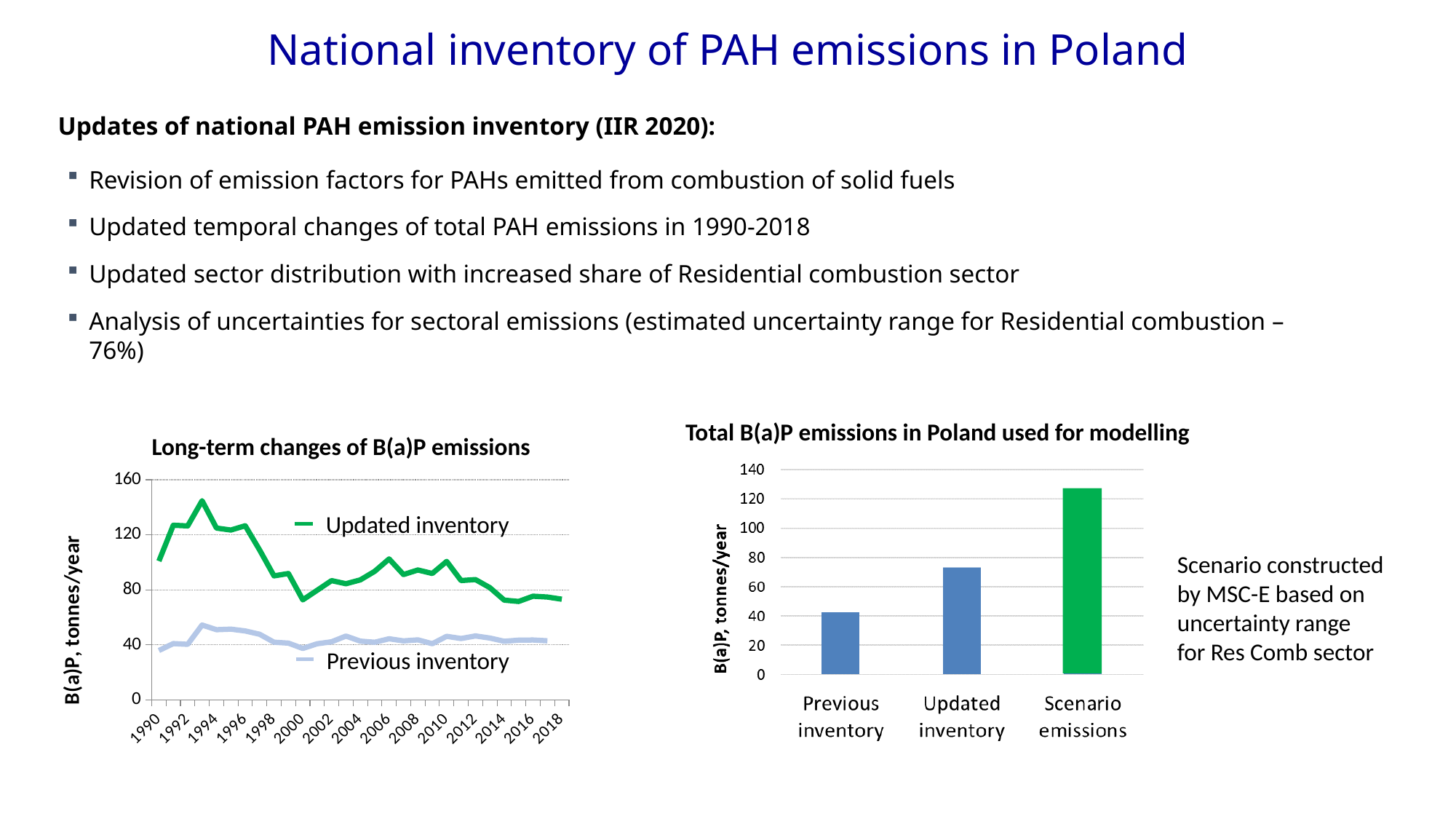
In the 'Long-term changes of B(a)P emissions' chart, which series has the larger value in 2000, Updated inventory or Previous inventory? Updated inventory In the 'Total B(a)P emissions in Poland used for modelling' chart, how many categories are shown? 3 In the 'Total B(a)P emissions in Poland used for modelling' chart, which category has the highest value? Scenario emissions In the 'Total B(a)P emissions in Poland used for modelling' chart, which category has the lowest value? Previous inventory In the 'Long-term changes of B(a)P emissions' chart, is the Updated inventory value for 1993 greater or less than 120? greater In the 'Total B(a)P emissions in Poland used for modelling' chart, is the value for Scenario emissions greater or less than 120? greater In the 'Long-term changes of B(a)P emissions' chart, how many series does the legend list? 2 In the 'Long-term changes of B(a)P emissions' chart, which series is shown in green? Updated inventory What kind of chart is the 'Long-term changes of B(a)P emissions' chart? line chart In the 'Long-term changes of B(a)P emissions' chart, is the Previous inventory value for 1990 greater or less than 40? less In the 'Long-term changes of B(a)P emissions' chart, does the Updated inventory series rise or fall between 1997 and 2000? fall What kind of chart is 'Total B(a)P emissions in Poland used for modelling'? bar chart